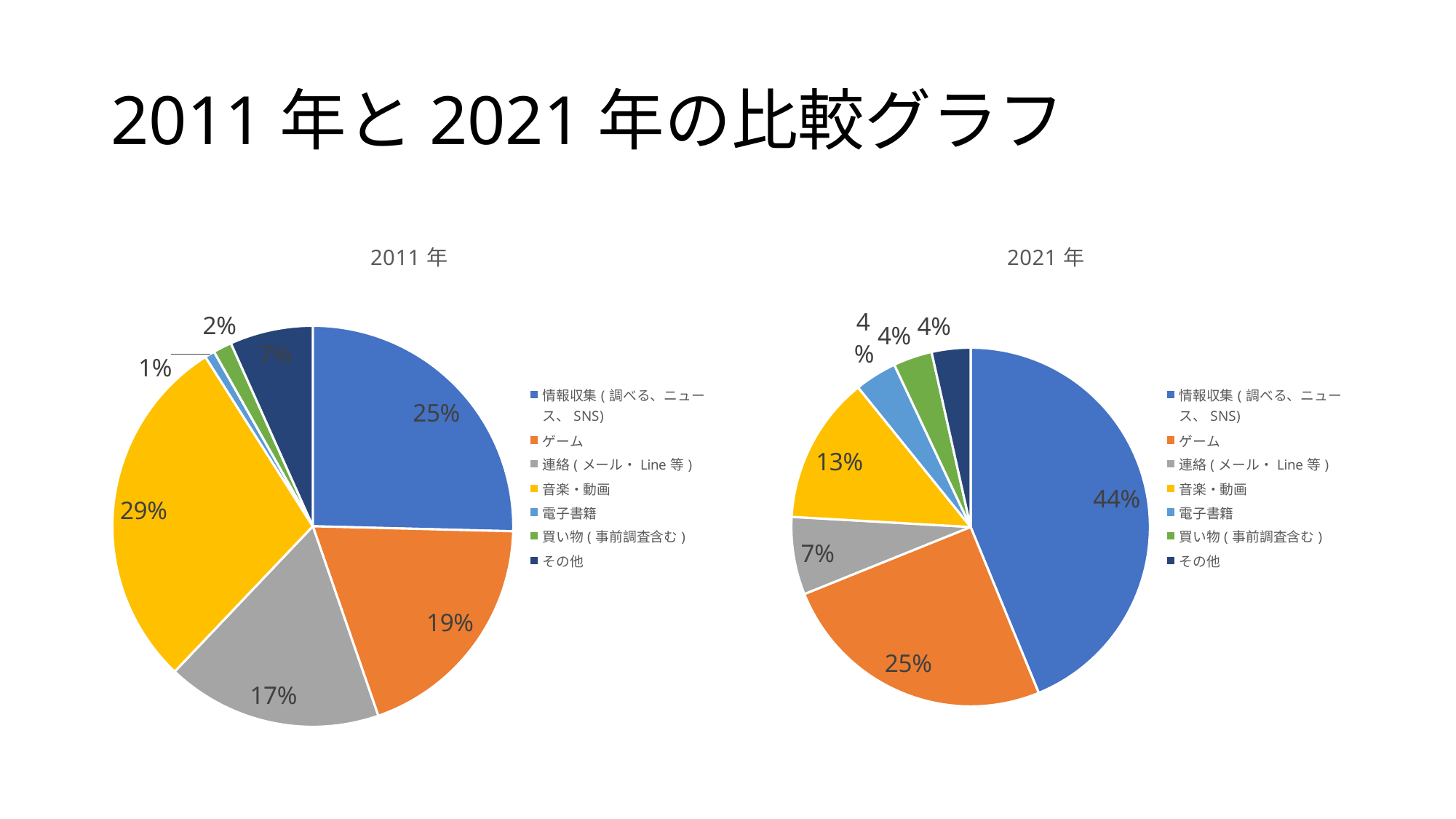
In the 2011年 chart, which category has the largest slice? 音楽・動画 In the 2021年 chart, which category has the largest slice? 情報収集 (調べる、ニュース、SNS) What kind of chart is the 2011年 chart? Pie chart In the 2011年 chart, what share does ゲーム have? 19% How many categories does the legend of the 2021年 chart list? 7 In the 2011年 chart, what share does 音楽・動画 have? 29% In the 2021年 chart, what share does 情報収集 (調べる、ニュース、SNS) have? 44% What is the difference between the 情報収集 share in the 2021年 chart and in the 2011年 chart? 19% What is the title of the slide? 2011年と2021年の比較グラフ In the 2011年 chart, which is larger, the share for ゲーム or the share for 連絡 (メール・Line等)? ゲーム In the 2021年 chart, what share does 連絡 (メール・Line等) have? 7% In the 2011年 chart, which category has the smallest slice? 電子書籍